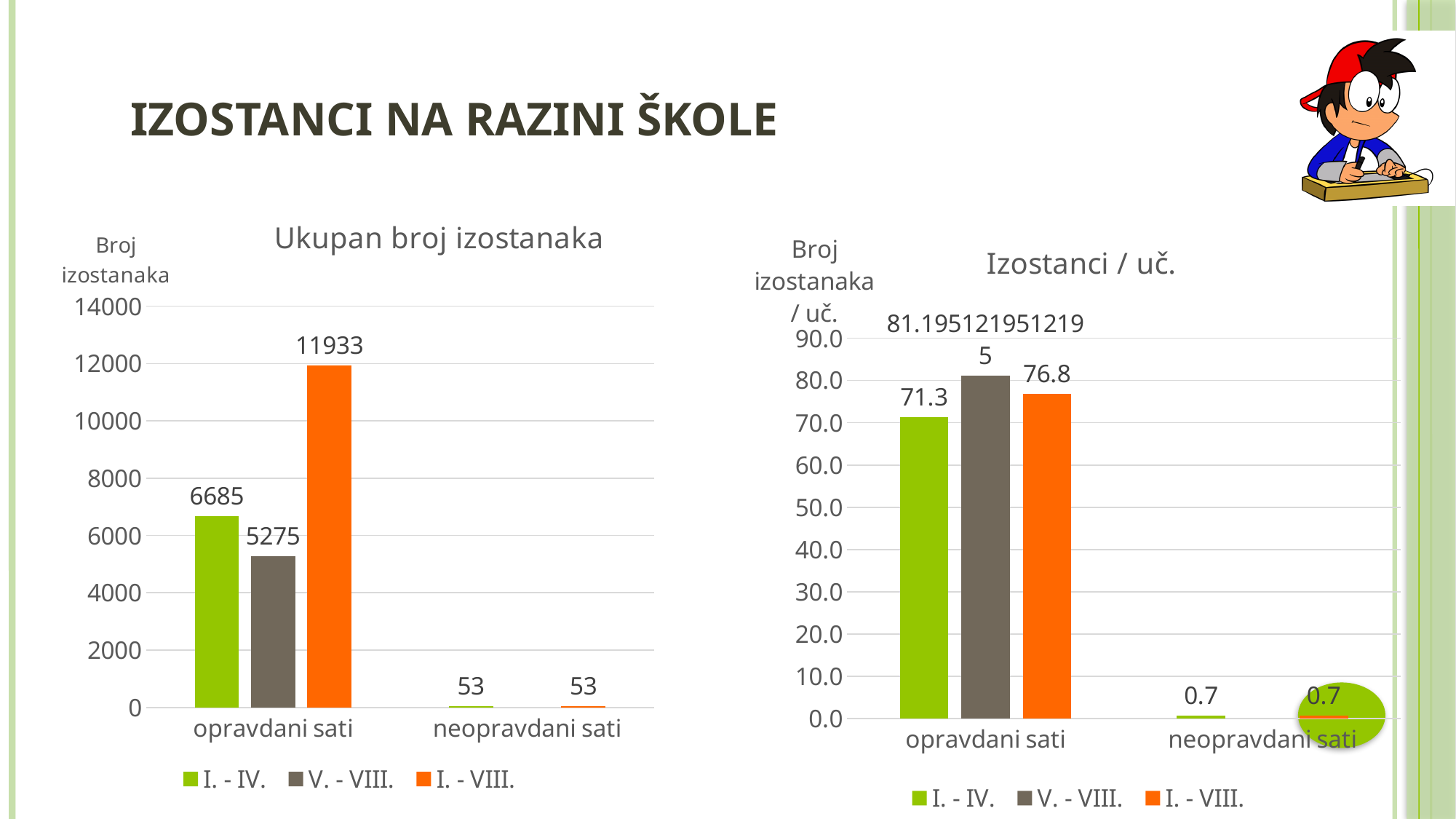
In the chart titled "Ukupan broj izostanaka", what is the value for I. - IV. in the opravdani sati category? 6685 In the chart titled "Ukupan broj izostanaka", which series has the highest value for opravdani sati? I. - VIII. In the chart titled "Ukupan broj izostanaka", what is the value for I. - IV. in the neopravdani sati category? 53 In the chart titled "Izostanci / uč.", what is the value for I. - VIII. in the neopravdani sati category? 0.7 In the chart titled "Ukupan broj izostanaka", what is the value for V. - VIII. in the opravdani sati category? 5275 In the chart titled "Ukupan broj izostanaka", what is the value for I. - VIII. in the opravdani sati category? 11933 In the chart titled "Izostanci / uč.", what is the value for I. - IV. in the opravdani sati category? 71.3 In the chart titled "Izostanci / uč.", which series has the lowest value for opravdani sati? I. - IV. How many series does the legend of the chart titled "Ukupan broj izostanaka" list? 3 In the chart titled "Ukupan broj izostanaka", what is the difference between the I. - IV. and V. - VIII. values for opravdani sati? 1410 What type of chart is the chart titled "Izostanci / uč."? Bar chart In the chart titled "Izostanci / uč.", what is the value for I. - VIII. in the opravdani sati category? 76.8